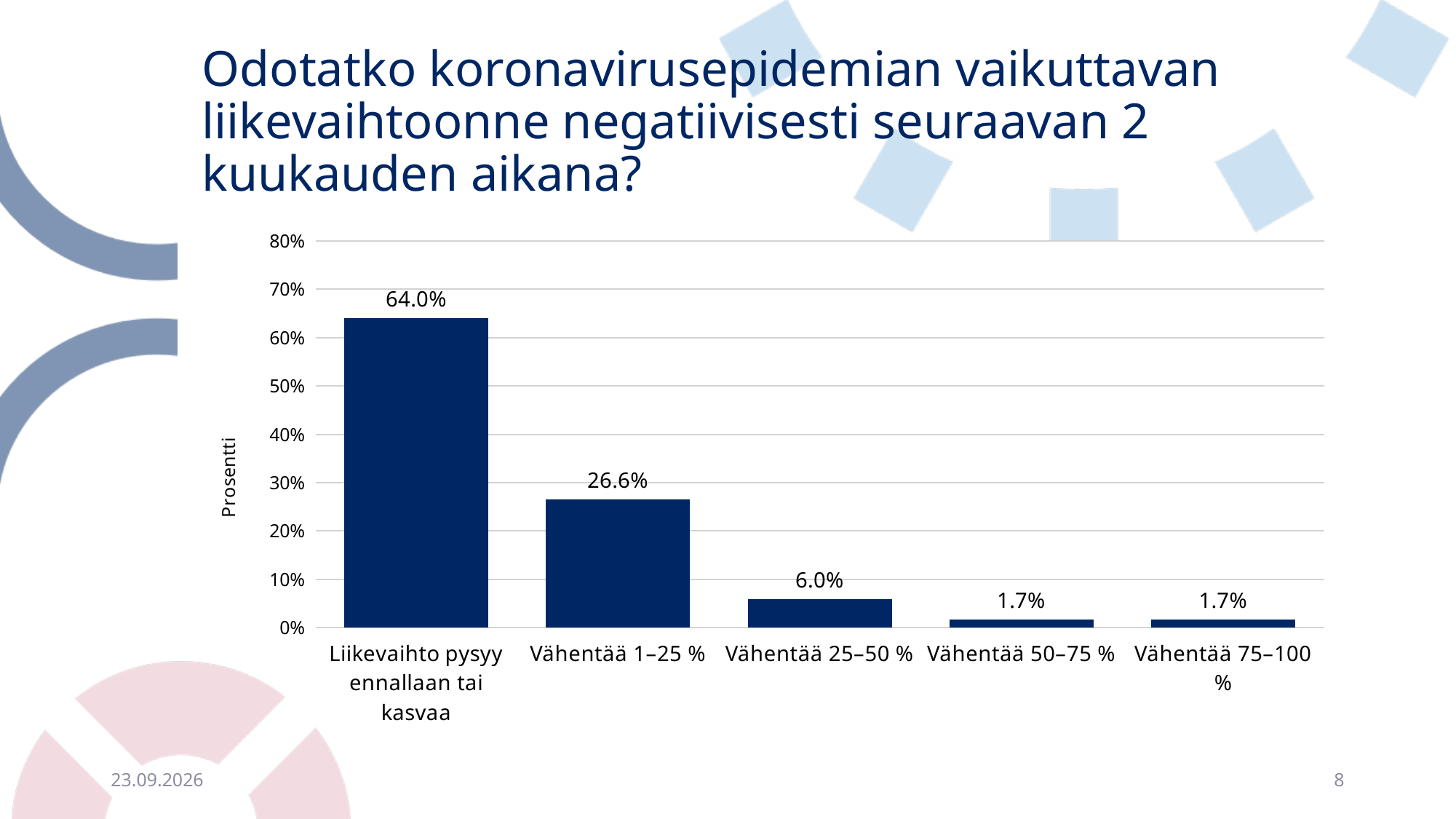
What kind of chart is shown on the slide? bar chart What is the value for "Vähentää 25–50 %"? 6.0% How many categories are shown on the x axis? 5 What is the difference between the values for "Liikevaihto pysyy ennallaan tai kasvaa" and "Vähentää 1–25 %"? 37.4% Is the value for "Liikevaihto pysyy ennallaan tai kasvaa" greater or less than 60%? greater What is the value for "Vähentää 50–75 %"? 1.7% What is the value for "Liikevaihto pysyy ennallaan tai kasvaa"? 64.0% Which is larger, the value for "Vähentää 1–25 %" or the value for "Vähentää 25–50 %"? Vähentää 1–25 % What is the label of the vertical axis? Prosentti Which category has the highest value? Liikevaihto pysyy ennallaan tai kasvaa What is the value for "Vähentää 1–25 %"? 26.6% Do the values rise or fall from left to right along the x axis? fall